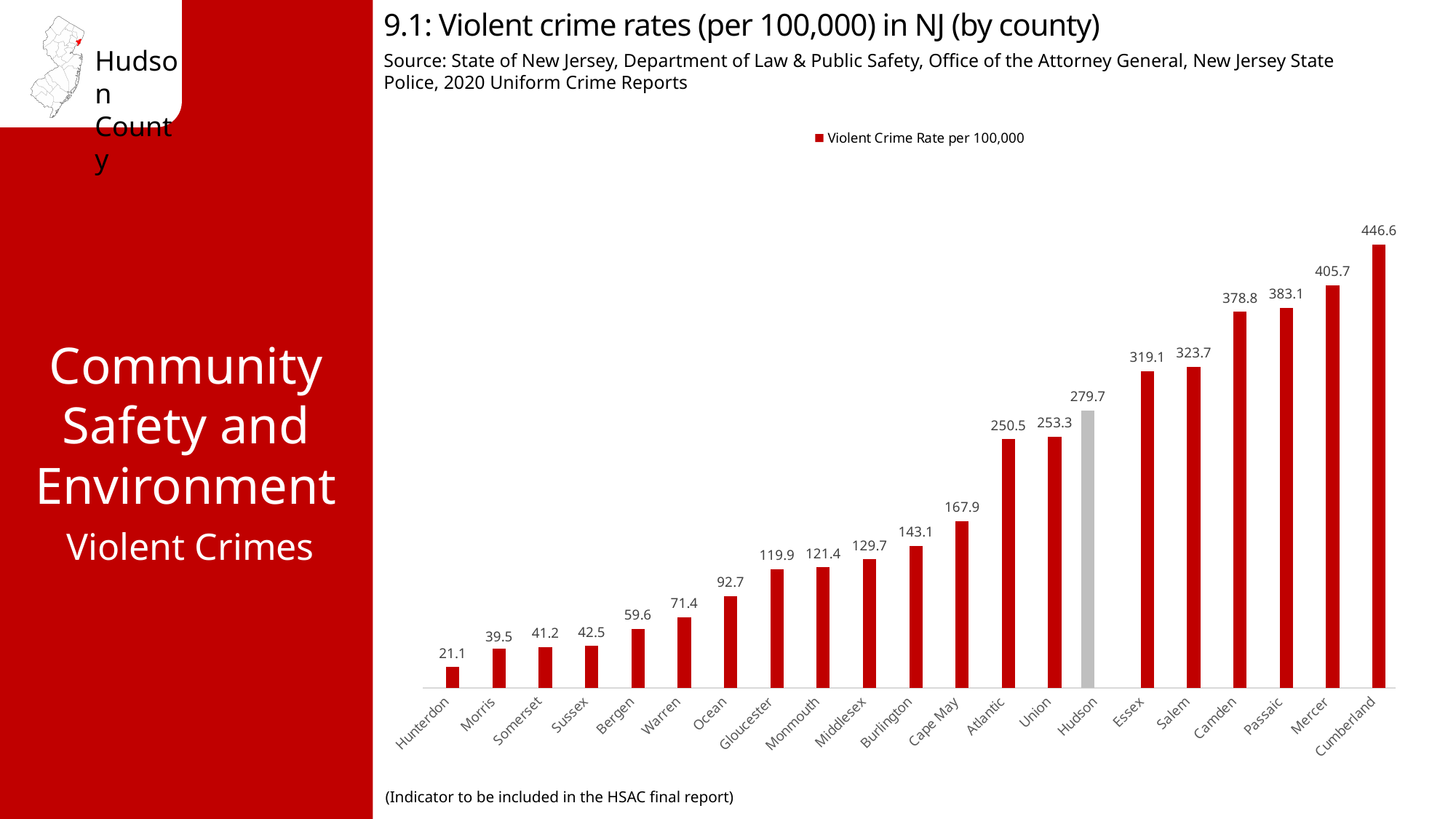
How many series does the legend list? 1 Which county has the lowest violent crime rate? Hunterdon What is the violent crime rate per 100,000 for Cape May? 167.9 Which county has the highest violent crime rate? Cumberland What is the difference between the violent crime rates of Cumberland and Hunterdon? 425.5 What type of chart is shown on the slide? Bar chart How many counties are shown in the chart? 21 Do the violent crime rates rise or fall from left to right across the counties? Rise What is the violent crime rate per 100,000 for Hudson County? 279.7 How much higher is Hudson's violent crime rate than Union's? 26.4 What is the violent crime rate per 100,000 for Bergen? 59.6 Which county has a higher violent crime rate, Mercer or Essex? Mercer